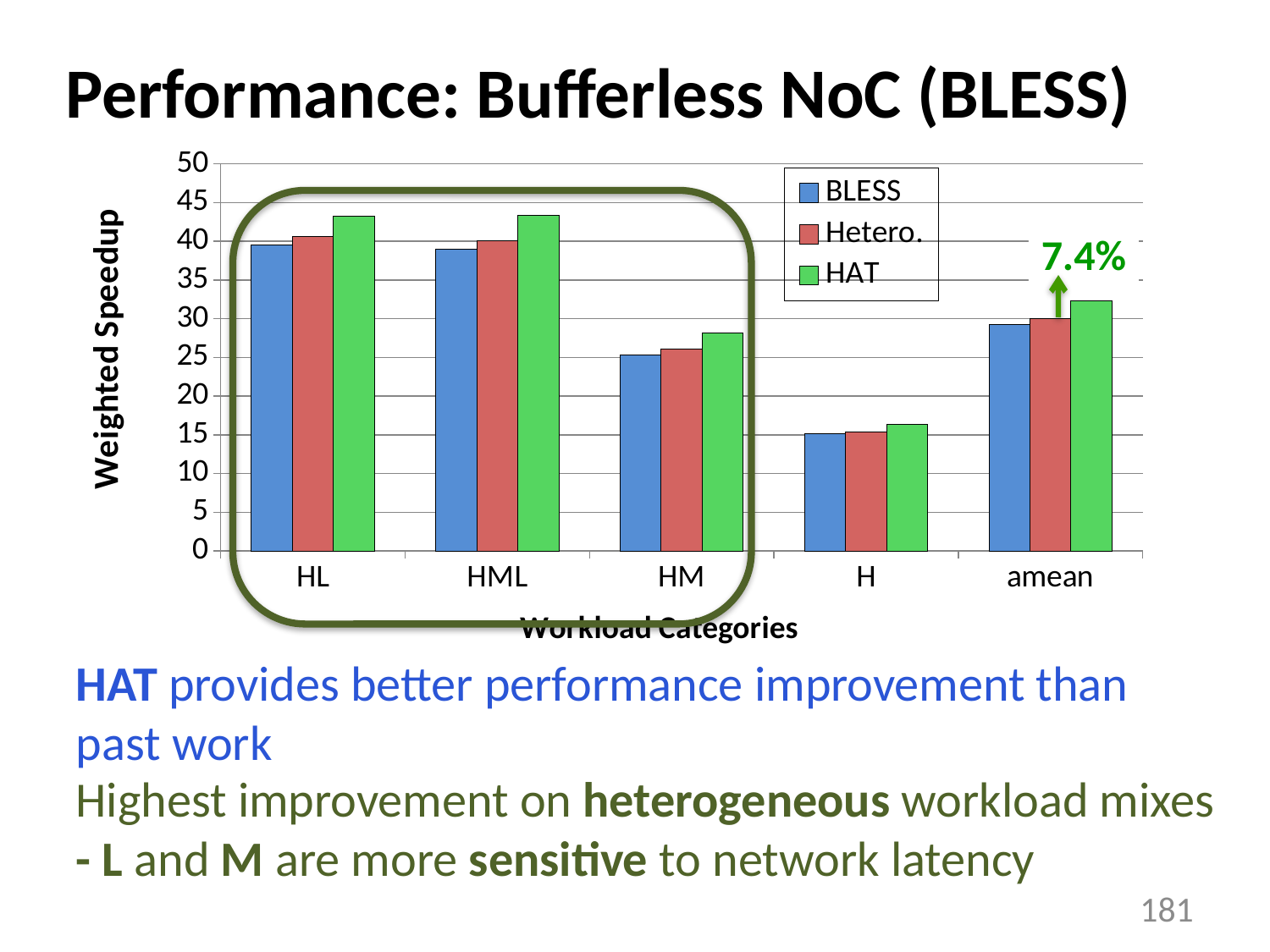
How many workload categories are shown on the x axis? 5 Is the HAT value for HM greater or less than 25? greater How many series does the legend list? 3 Which workload category has the lowest weighted speedup for BLESS? H What kind of chart is shown on the slide? bar chart What is the label of the y axis? Weighted Speedup Which workload category has the lowest weighted speedup for HAT? H What percentage improvement is annotated above the amean group? 7.4% For the HM category, which is larger: the HAT value or the BLESS value? HAT Is the HAT value for HL greater or less than 40? greater Is the BLESS value for HML greater or less than 40? less